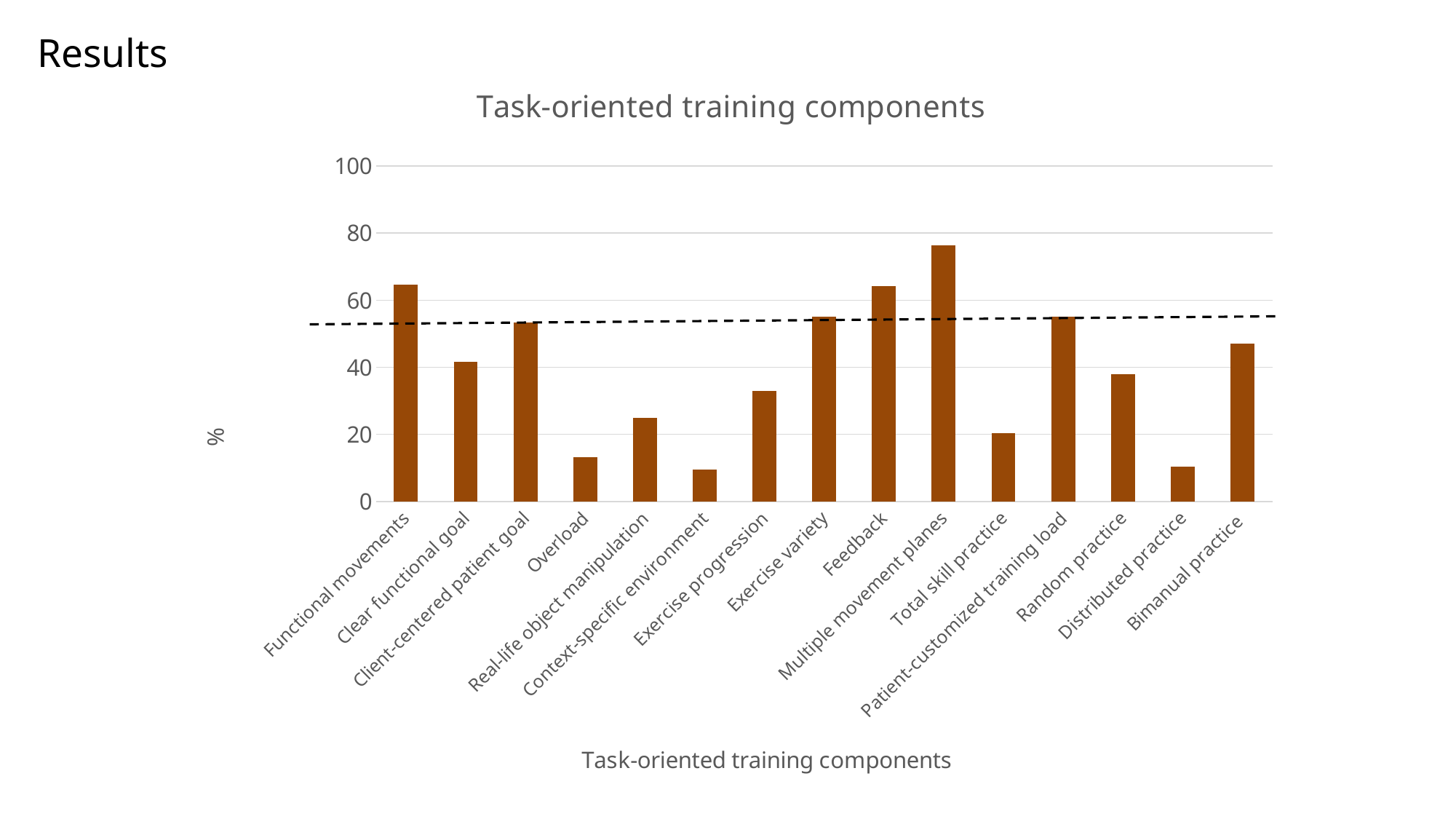
Which has a higher value, Feedback or Clear functional goal? Feedback Which has a higher value, Overload or Exercise progression? Exercise progression Is the value for Random practice greater or less than 40? less Is the value for Overload greater or less than 20? less What is the title of the chart? Task-oriented training components Is the value for Multiple movement planes greater or less than 80? less How many task-oriented training components are plotted in the chart? 15 What kind of chart is shown on the slide? bar chart Which task-oriented training component has the highest percentage? Multiple movement planes